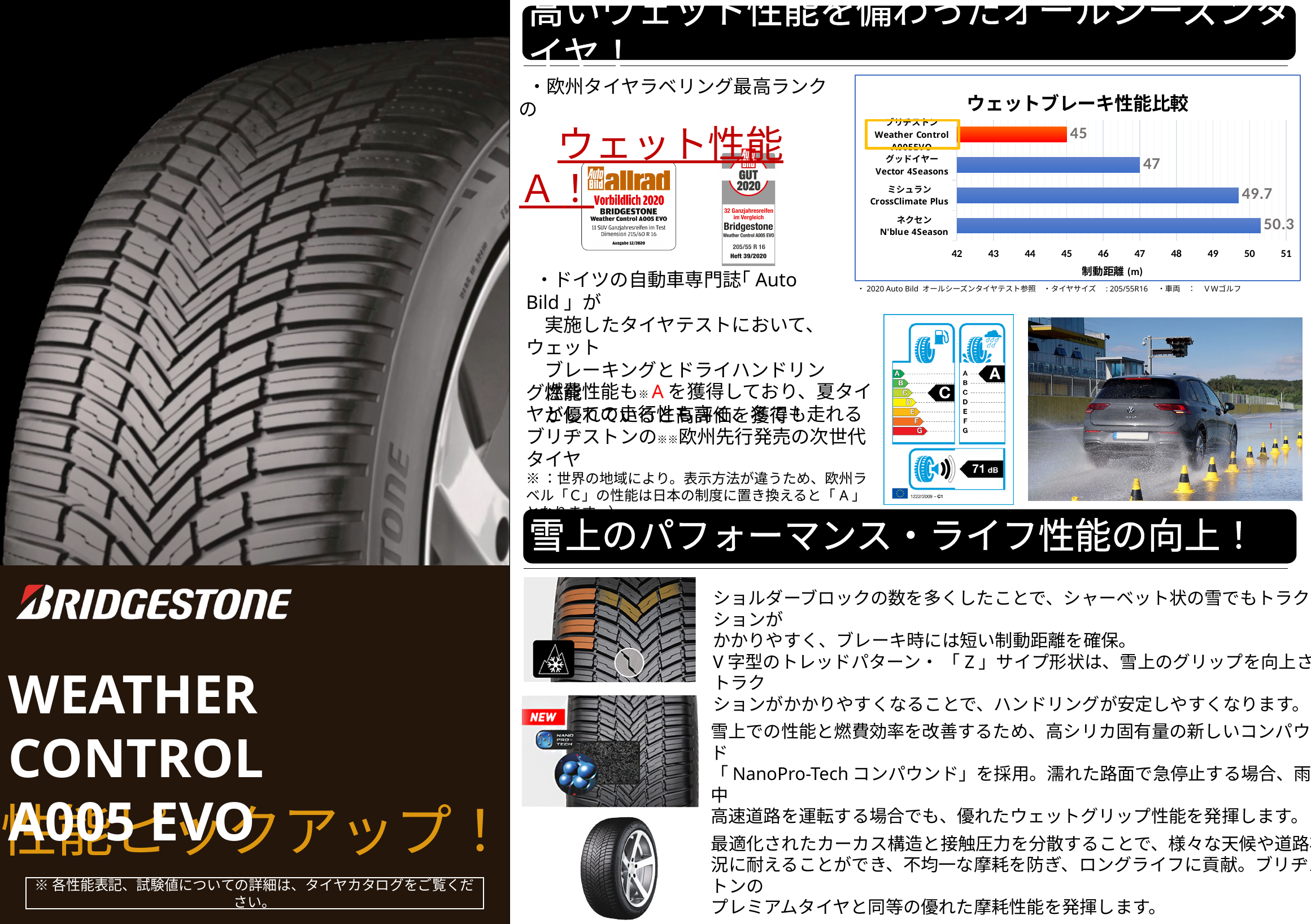
In the ウェットブレーキ性能比較 chart, what is the braking distance for ブリヂストン Weather Control A005EVO? 45 In the ウェットブレーキ性能比較 chart, what is the braking distance for ミシュラン CrossClimate Plus? 49.7 In the ウェットブレーキ性能比較 chart, what is the braking distance for グッドイヤー Vector 4Seasons? 47 What is the x-axis label of the ウェットブレーキ性能比較 chart? 制動距離 (m) What type of chart is the ウェットブレーキ性能比較 chart? Bar chart In the ウェットブレーキ性能比較 chart, which tire has the longest braking distance? ネクセン N'blue 4Season In the ウェットブレーキ性能比較 chart, what is the difference in braking distance between ネクセン N'blue 4Season and ブリヂストン Weather Control A005EVO? 5.3 How many tires are compared in the ウェットブレーキ性能比較 chart? 4 In the ウェットブレーキ性能比較 chart, which tire has the shortest braking distance? ブリヂストン Weather Control A005EVO In the ウェットブレーキ性能比較 chart, what is the braking distance for ネクセン N'blue 4Season? 50.3 In the ウェットブレーキ性能比較 chart, what is the difference in braking distance between ミシュラン CrossClimate Plus and グッドイヤー Vector 4Seasons? 2.7 In the ウェットブレーキ性能比較 chart, which has a longer braking distance, グッドイヤー Vector 4Seasons or ミシュラン CrossClimate Plus? ミシュラン CrossClimate Plus